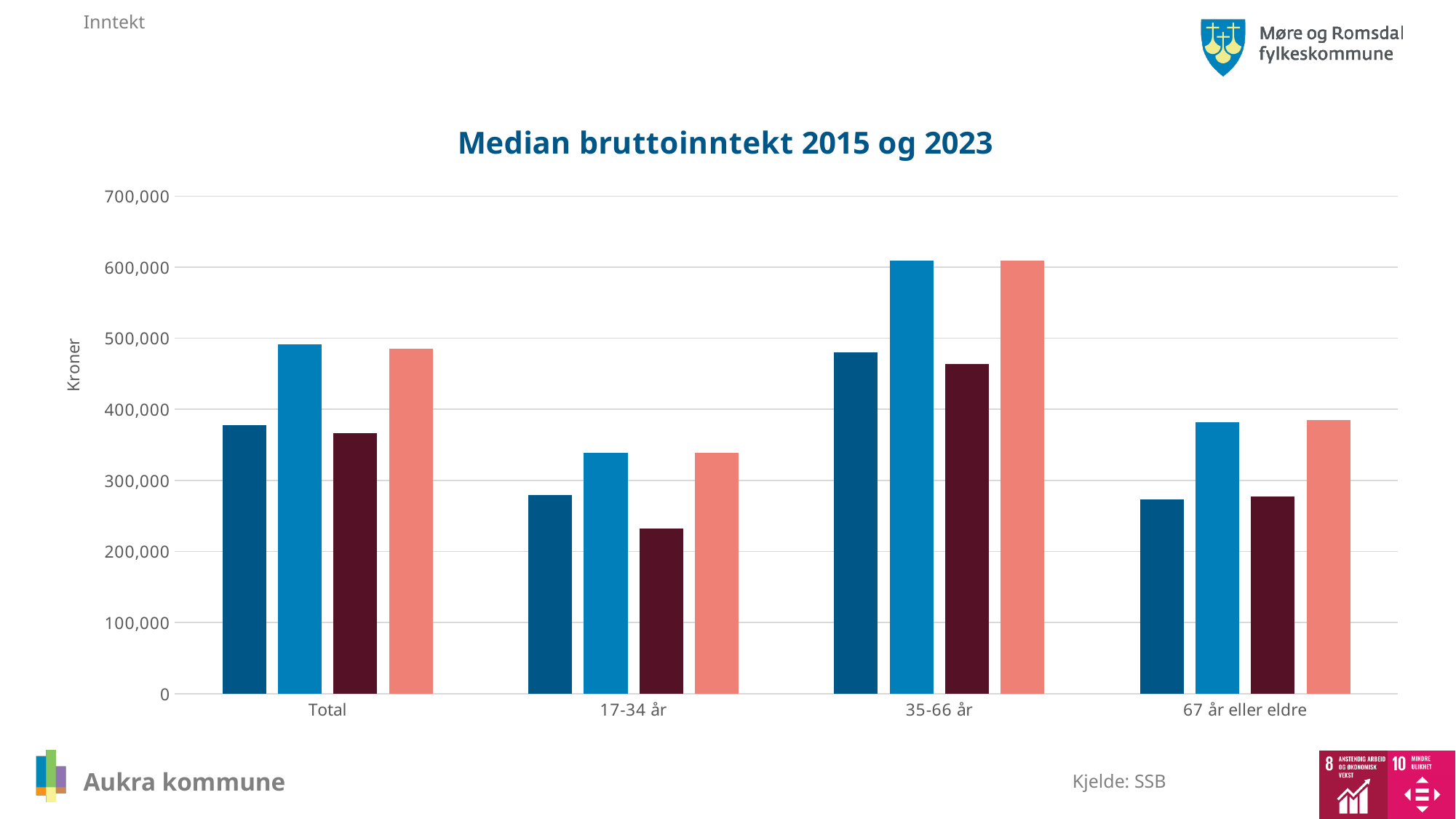
How many categories are shown on the x axis of the chart? 4 What kind of chart is shown on the slide? bar chart Is the value of the dark red bar for 17-34 år greater or less than 200,000? greater Is the value of the light blue bar for Total greater or less than 500,000? less What is the label of the y axis of the chart? Kroner Is the value of the salmon (last) bar for 67 år eller eldre greater or less than 400,000? less Which is larger: the dark red bar for 17-34 år or the dark red bar for 67 år eller eldre? 67 år eller eldre What is the title of the chart? Median bruttoinntekt 2015 og 2023 Which category has the tallest bars in the chart? 35-66 år Which is larger: the light blue bar for 17-34 år or the light blue bar for 67 år eller eldre? 67 år eller eldre